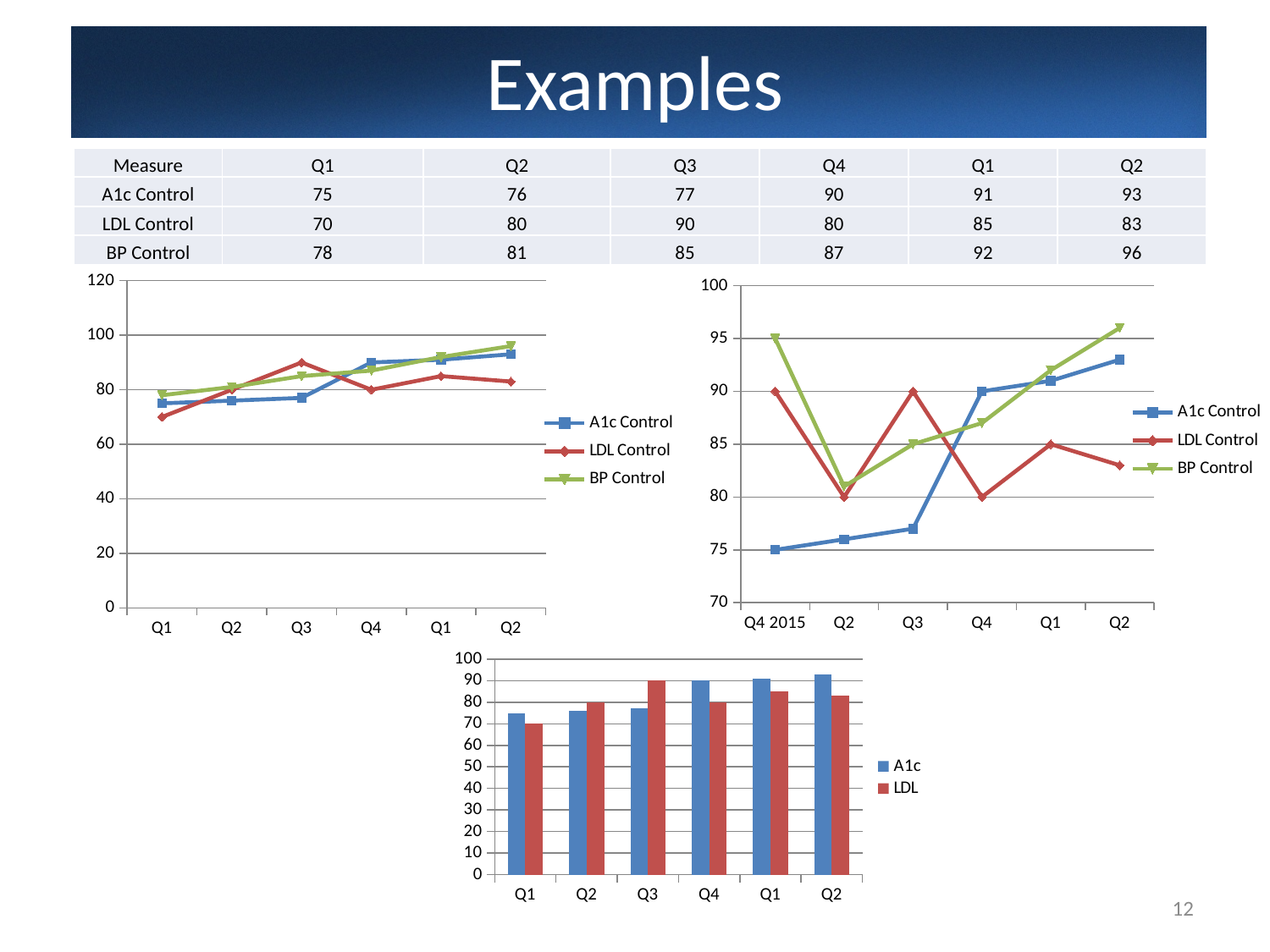
In the top-left line chart, does the A1c Control series rise or fall from the first Q1 to the last Q2? rise In the top-right line chart, which series has the highest value at the final Q2? BP Control In the bottom bar chart, what is the value of LDL for Q3? 90 In the top-right line chart, is the value of A1c Control at Q4 2015 greater or less than 80? less How many series does the legend of the bottom bar chart list? 2 What kind of chart is the chart at the bottom of the slide? bar chart How many series does the legend of the top-left line chart list? 3 In the bottom bar chart, which is larger for Q4, A1c or LDL? A1c In the bottom bar chart, what is the value of A1c for the first Q1? 75 In the bottom bar chart, what is the difference between A1c and LDL for the last Q2? 10 What kind of chart is the chart at the top left of the slide? line chart How many categories are shown on the x axis of the bottom bar chart? 6